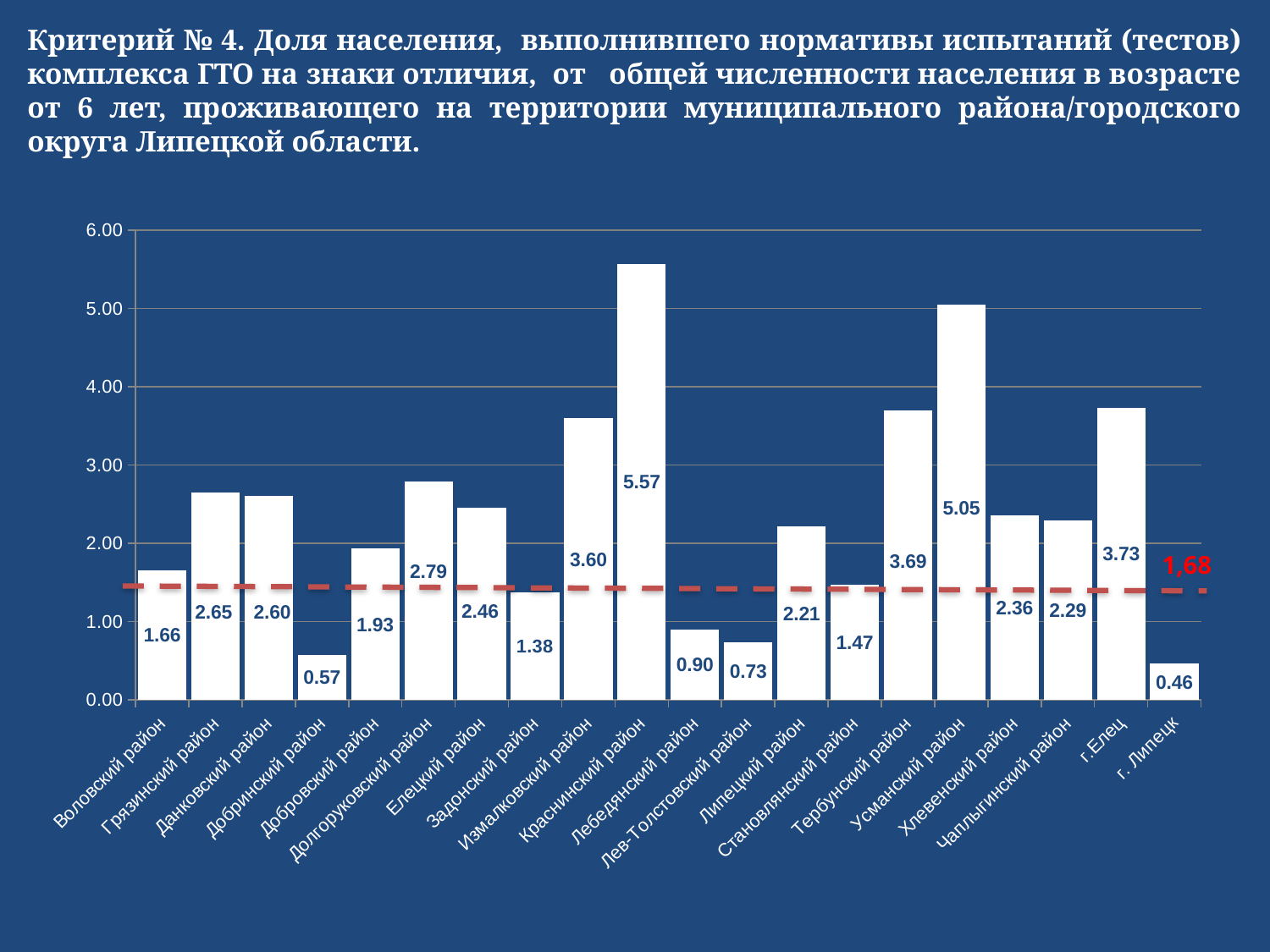
Which category has the lowest value? г. Липецк What kind of chart is shown on the slide? bar chart Is the value for Измалковский район greater or less than 3.00? greater Which category has the highest value? Краснинский район What is the value for г. Липецк? 0.46 Which is larger, the value for Тербунский район or the value for г.Елец? г.Елец What value is labelled on the red dashed horizontal line? 1,68 What is the value for Усманский район? 5.05 What is the difference between the values for Грязинский район and Данковский район? 0.05 What is the difference between the values for Краснинский район and Усманский район? 0.52 How many categories are shown on the x axis? 20 What is the value for Краснинский район? 5.57